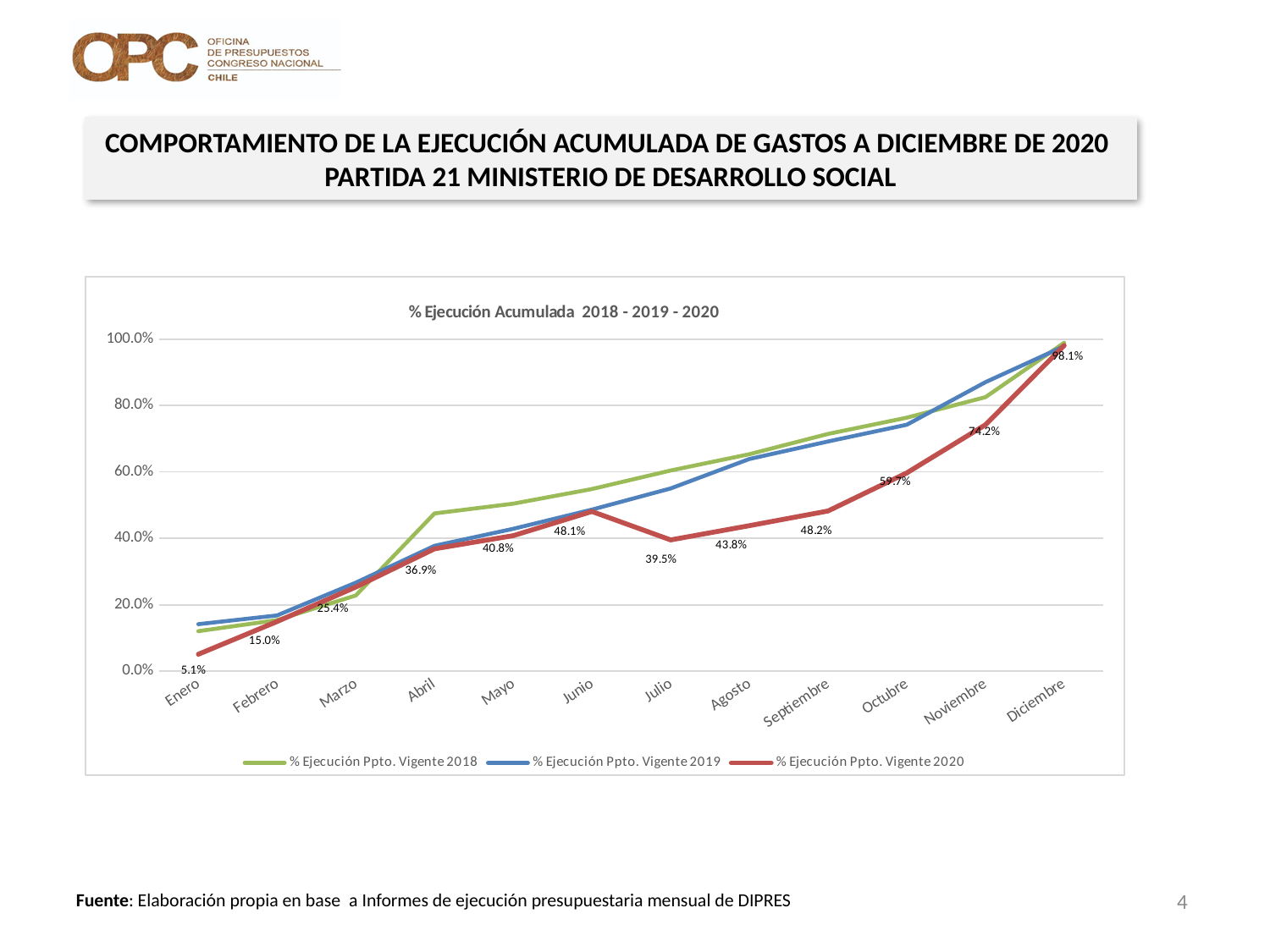
How many series does the legend list? 3 What is the value for Noviembre in the % Ejecución Ppto. Vigente 2020 series? 74.2% In the % Ejecución Ppto. Vigente 2020 series, which is larger, the value for Junio or the value for Julio? Junio What is the value for Diciembre in the % Ejecución Ppto. Vigente 2020 series? 98.1% How many months are shown on the x axis? 12 What kind of chart is shown on the slide? Line chart In which month is the % Ejecución Ppto. Vigente 2020 series lowest? Enero What is the value for Enero in the % Ejecución Ppto. Vigente 2020 series? 5.1% What is the difference between the Octubre and Septiembre values in the % Ejecución Ppto. Vigente 2020 series? 11.5% In which month is the % Ejecución Ppto. Vigente 2020 series highest? Diciembre What is the value for Julio in the % Ejecución Ppto. Vigente 2020 series? 39.5% Is the value for Abril in the % Ejecución Ppto. Vigente 2018 series greater or less than 40.0%? greater